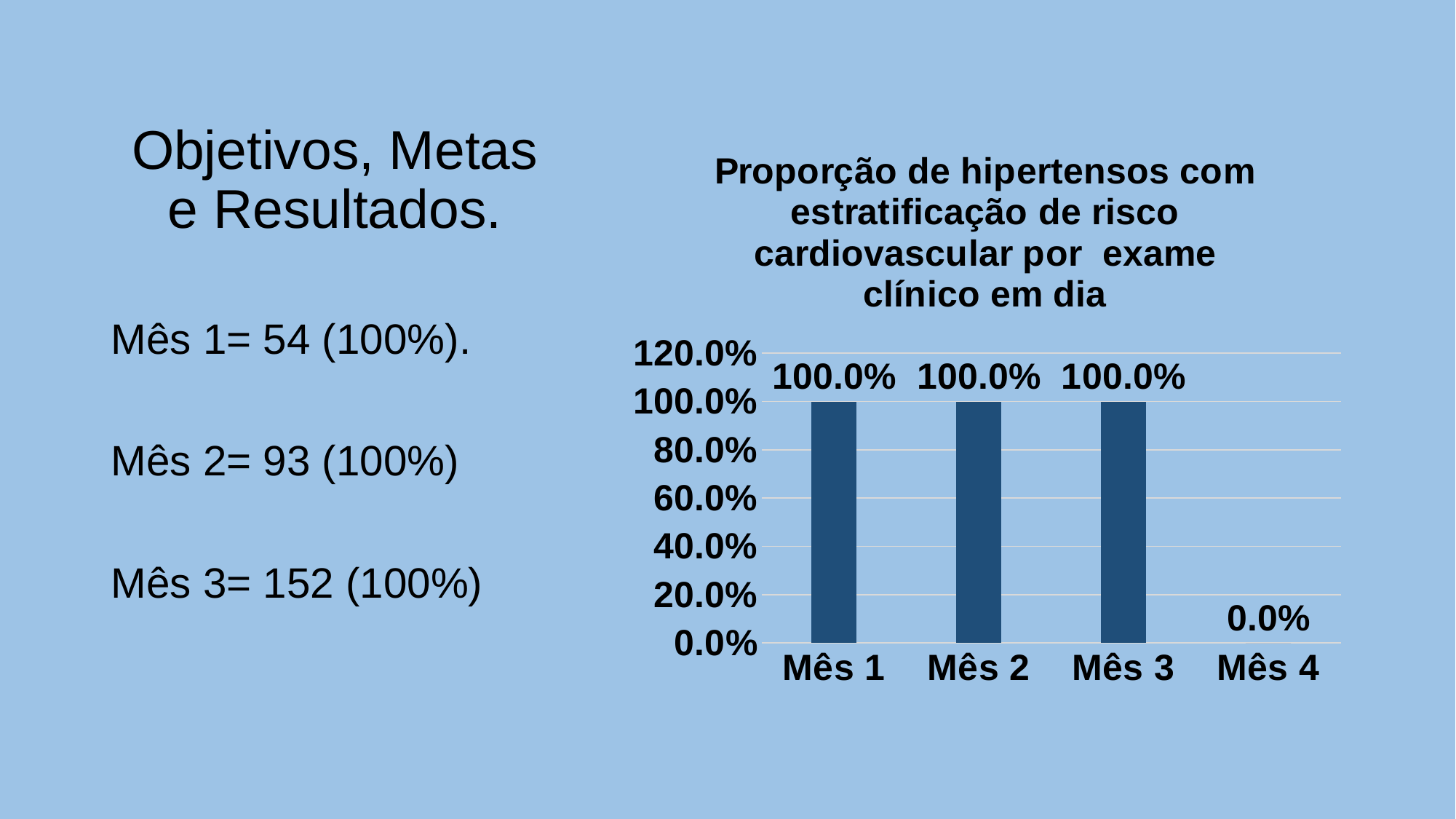
What is the title of the chart? Proporção de hipertensos com estratificação de risco cardiovascular por exame clínico em dia What is the value for Mês 1? 100.0% What is the value for Mês 4? 0.0% Which category has the lowest value? Mês 4 How many categories are shown on the x axis? 4 What kind of chart is shown on the slide? bar chart What is the value for Mês 2? 100.0% What is the difference between the values for Mês 3 and Mês 4? 100.0% What is the highest value shown on the y axis? 120.0% Is the value for Mês 2 greater or less than 80.0%? greater What is the value for Mês 3? 100.0% Which is larger, the value for Mês 1 or the value for Mês 4? Mês 1